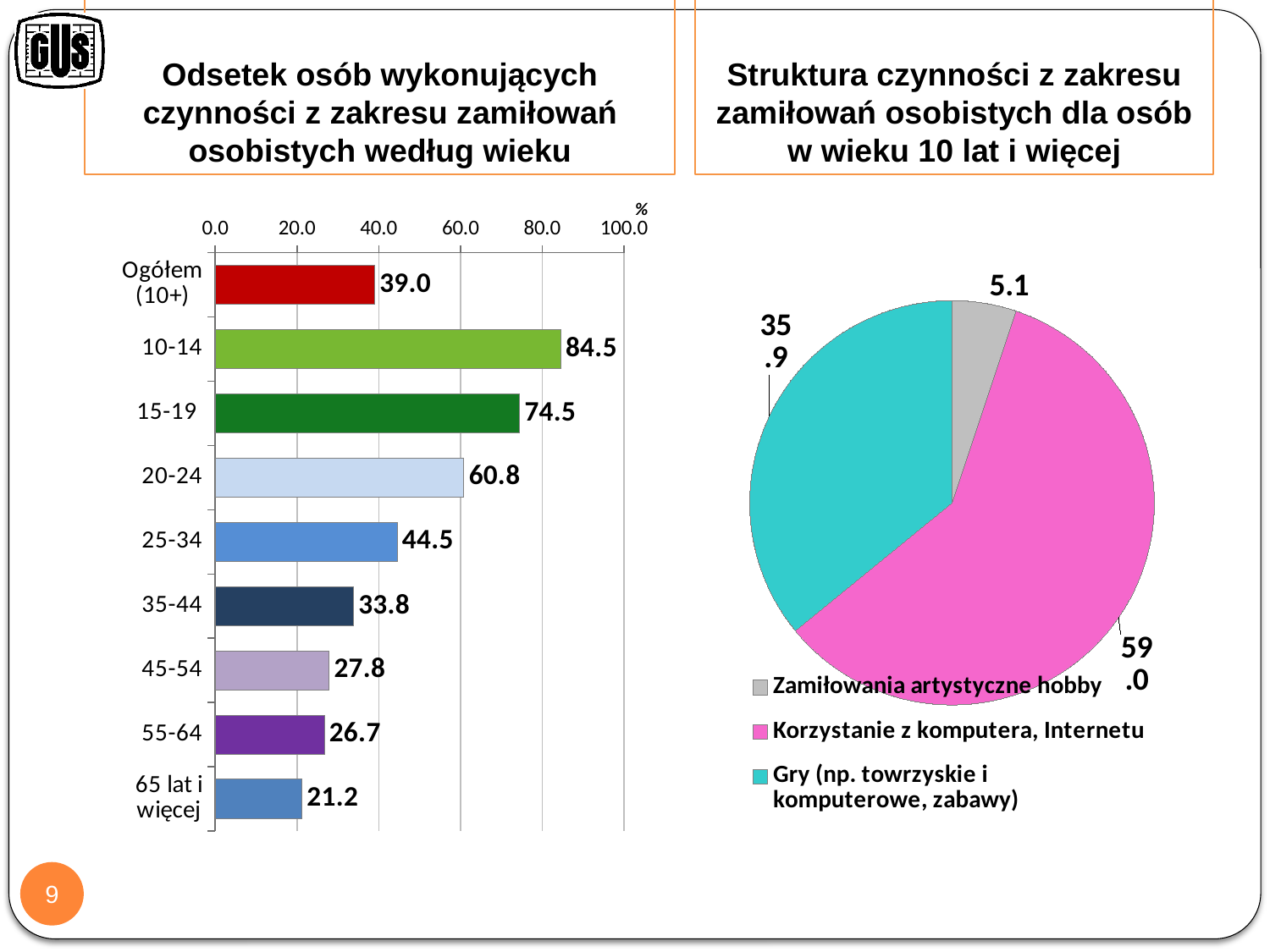
In the left chart (Odsetek osób wykonujących czynności z zakresu zamiłowań osobistych według wieku), what is the value for the 10-14 age group? 84.5 In the right chart, how many categories does the legend list? 3 In the right chart, which category has the smallest slice? Zamiłowania artystyczne hobby In the left chart, do the values rise or fall going from the 10-14 group down to the 65 lat i więcej group? fall In the left chart, what is the difference between the values for 15-19 and 20-24? 13.7 In the left chart, which is larger: the value for 25-34 or the value for 35-44? 25-34 What kind of chart is the left chart? bar chart In the right chart (Struktura czynności z zakresu zamiłowań osobistych), what is the value for Korzystanie z komputera, Internetu? 59.0 In the left chart, which age group has the lowest value? 65 lat i więcej In the left chart, what is the value for Ogółem (10+)? 39.0 In the left chart, how many age categories (bars) are shown? 9 In the left chart, which age group has the highest value? 10-14